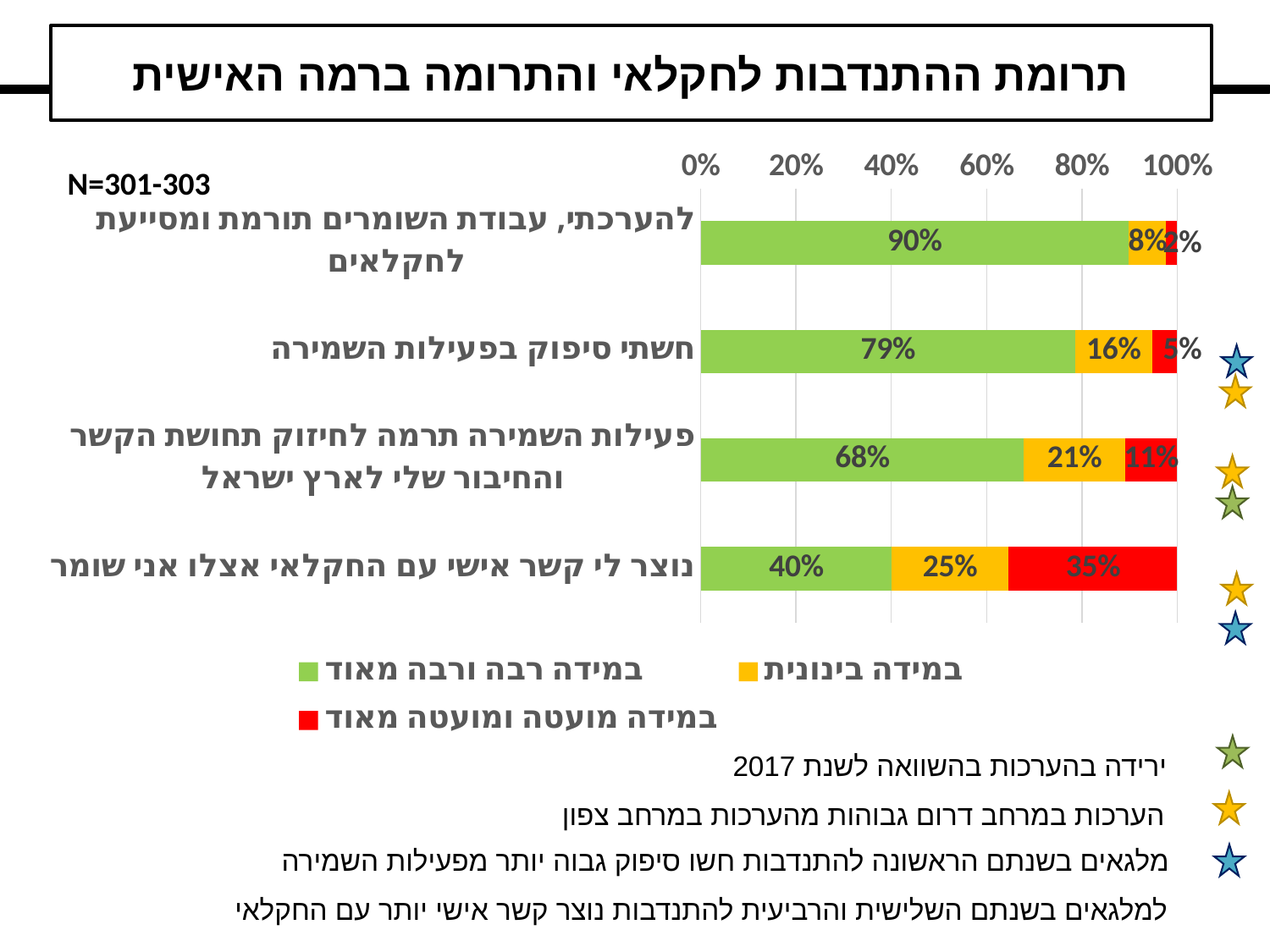
Which statement has the lowest value for 'במידה רבה ורבה מאוד'? נוצר לי קשר אישי עם החקלאי אצלו אני שומר What type of chart is shown on the slide? Stacked bar chart What is the total of the stacked bar for 'להערכתי, עבודת השומרים תורמת ומסייעת לחקלאים'? 100% What is the value of 'במידה מועטה ומועטה מאוד' for the statement 'פעילות השמירה תרמה לחיזוק תחושת הקשר והחיבור שלי לארץ ישראל'? 11% How many categories (statements) are plotted in the chart? 4 What colour represents the series 'במידה בינונית' in the legend? Yellow What is the value of 'במידה בינונית' for the statement 'נוצר לי קשר אישי עם החקלאי אצלו אני שומר'? 25% What is the difference between the 'במידה רבה ורבה מאוד' values for 'חשתי סיפוק בפעילות השמירה' and 'פעילות השמירה תרמה לחיזוק תחושת הקשר והחיבור שלי לארץ ישראל'? 11% Which is larger: the 'במידה מועטה ומועטה מאוד' value for 'נוצר לי קשר אישי עם החקלאי אצלו אני שומר' or for 'חשתי סיפוק בפעילות השמירה'? נוצר לי קשר אישי עם החקלאי אצלו אני שומר What is the value of 'במידה רבה ורבה מאוד' for the statement 'חשתי סיפוק בפעילות השמירה'? 79% Which statement has the highest value for 'במידה רבה ורבה מאוד'? להערכתי, עבודת השומרים תורמת ומסייעת לחקלאים How many series does the legend list? 3